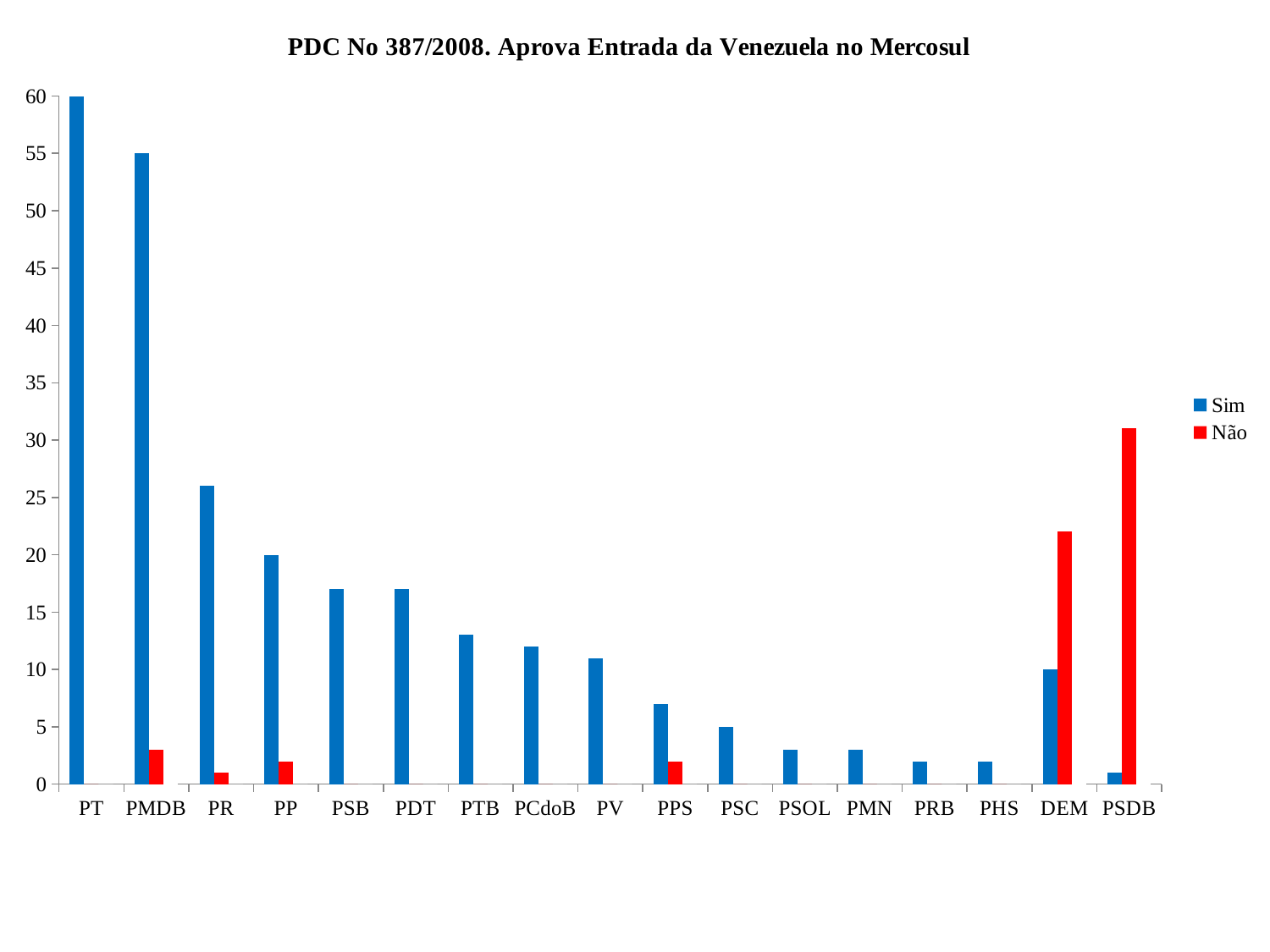
Which party has the lowest Sim value? PSDB Which party has the highest Sim value? PT How many parties (categories) are shown on the x axis? 17 Which party has the highest Não value? PSDB What is the difference between the Sim values for PT and PMDB? 5 What is the Sim value for PT? 60 Is the Sim value for PR greater or less than 25? greater For DEM, which is larger, the Sim value or the Não value? Não What is the Sim value for DEM? 10 How many series does the legend list? 2 What type of chart is shown on the slide? bar chart What is the Sim value for PMDB? 55